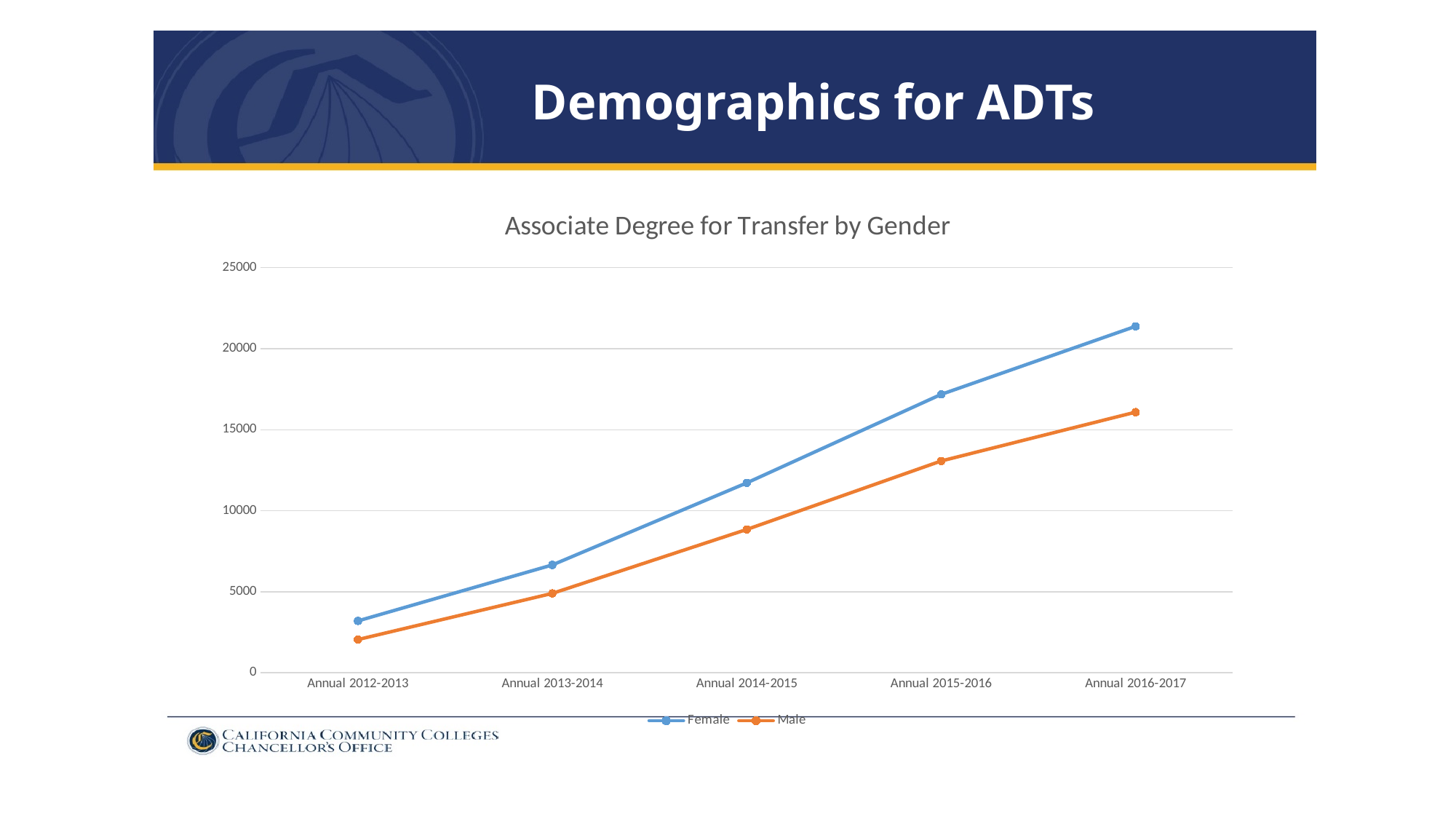
How many annual periods are plotted along the x axis? 5 In which annual period is the Female value lowest? Annual 2012-2013 Is the Male value for Annual 2014-2015 greater or less than 10000? less Do the Female values rise or fall from Annual 2012-2013 to Annual 2016-2017? Rise In which annual period is the Male value highest? Annual 2016-2017 Is the Female value for Annual 2016-2017 greater or less than 20000? greater Is the Female value for Annual 2012-2013 greater or less than 5000? less What is the title of the chart? Associate Degree for Transfer by Gender How many series does the legend list? 2 What kind of chart is shown on the slide? Line chart In Annual 2016-2017, which series has the larger value, Female or Male? Female